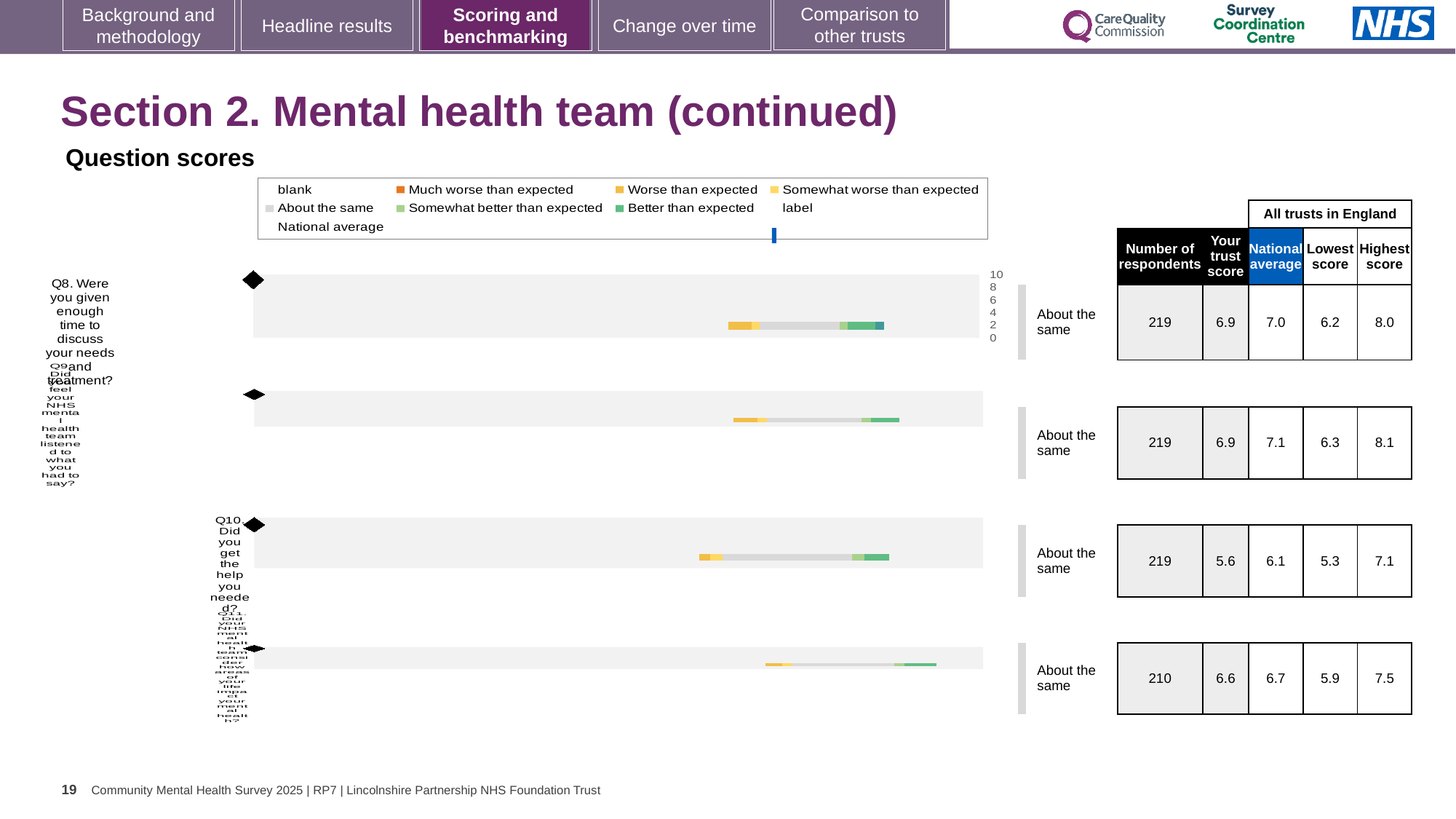
What is the lowest score across all trusts in England for Q9? 6.3 What benchmark category is shown next to the bar for Q11? About the same In the legend, what colour represents 'Much worse than expected'? Orange Which question has the lowest 'Your trust score' value? Q10 Which question has the highest 'Highest score' value in the table? Q9 How many respondents are listed for Q11? 210 What kind of chart is used to show the question scores on this slide? bar chart How many questions (Q8 to Q11) have a benchmarking bar on this slide? 4 What is the 'Your trust score' value for Q8 (Were you given enough time to discuss your needs and treatment?)? 6.9 For Q8, which is larger: the trust score or the national average? National average What is the national average score for Q10 (Did you get the help you needed?)? 6.1 For Q10, what is the difference between the national average and the trust score? 0.5